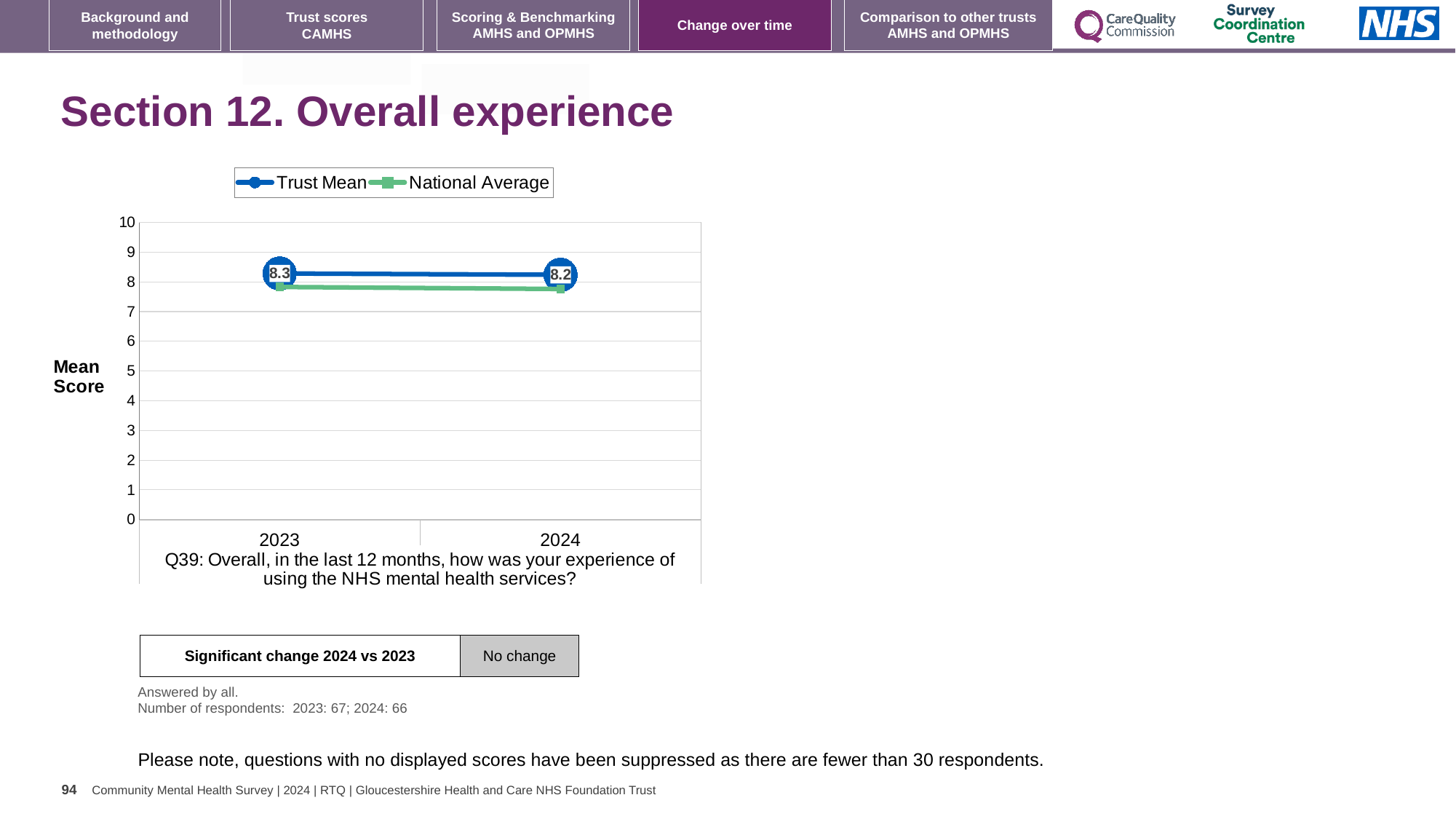
What is the Trust Mean score for 2024? 8.2 Does the Trust Mean score rise or fall from 2023 to 2024? Fall Is the National Average value for 2023 greater or less than 7? greater What are the two series named in the chart legend? Trust Mean and National Average How many years are plotted on the x axis of the chart? 2 What is the Trust Mean score for 2023? 8.3 What is the label on the y axis of the chart? Mean Score What kind of chart is shown on the slide? Line chart By how much did the Trust Mean score change between 2023 and 2024? 0.1 In 2024, which series has the higher value, Trust Mean or National Average? Trust Mean How many series does the chart legend list? 2 Which year has the higher Trust Mean score, 2023 or 2024? 2023